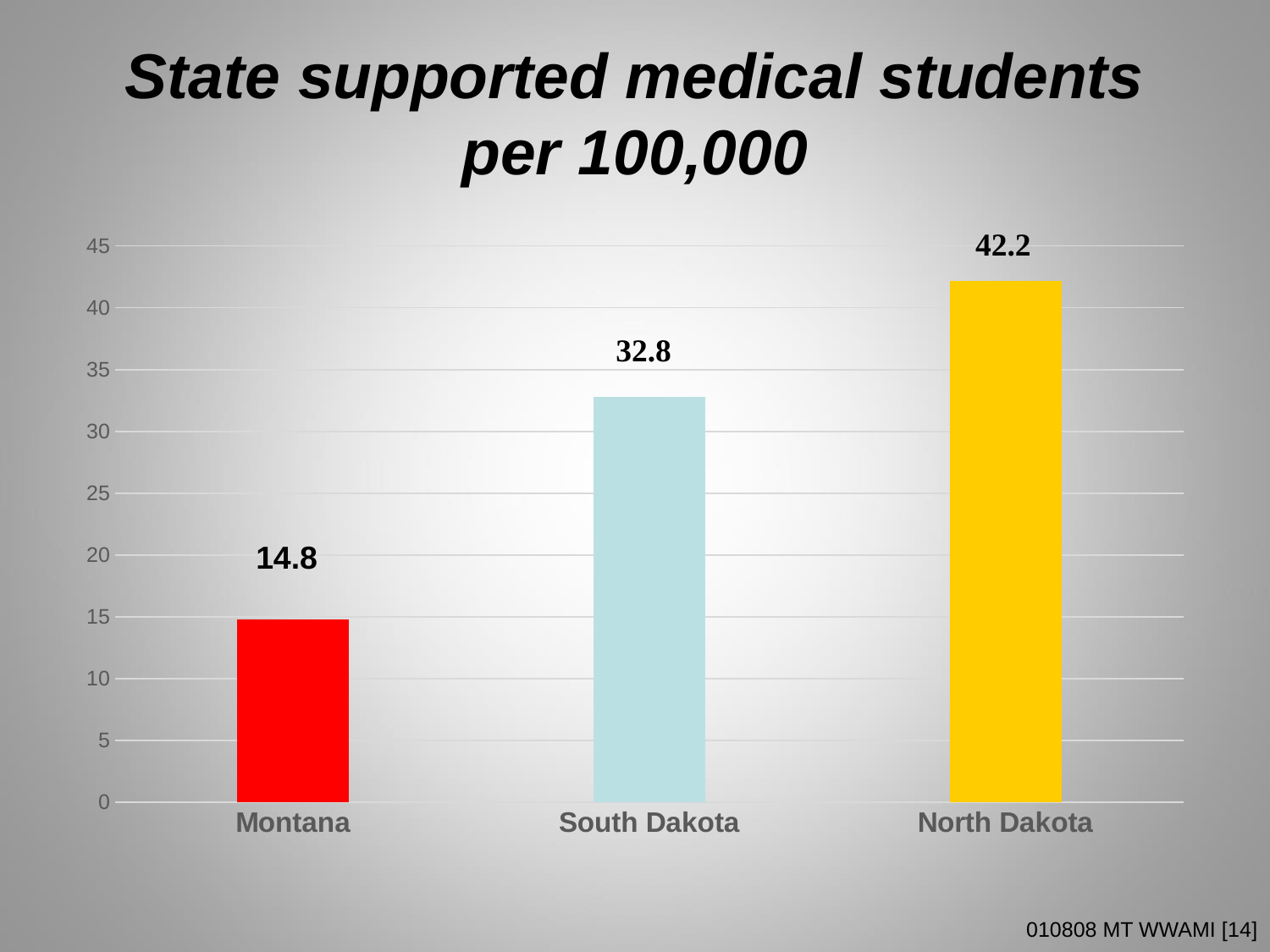
Which state has the lowest value? Montana How many states are shown in the chart? 3 What is the title of the chart? State supported medical students per 100,000 Which state has the highest value? North Dakota What is the value for Montana? 14.8 What is the difference between the values for North Dakota and Montana? 27.4 What is the value for North Dakota? 42.2 Is the value for South Dakota greater or less than 30? greater Which is larger, the value for South Dakota or the value for Montana? South Dakota What is the value for South Dakota? 32.8 What is the difference between the values for North Dakota and South Dakota? 9.4 What kind of chart is shown on the slide? bar chart